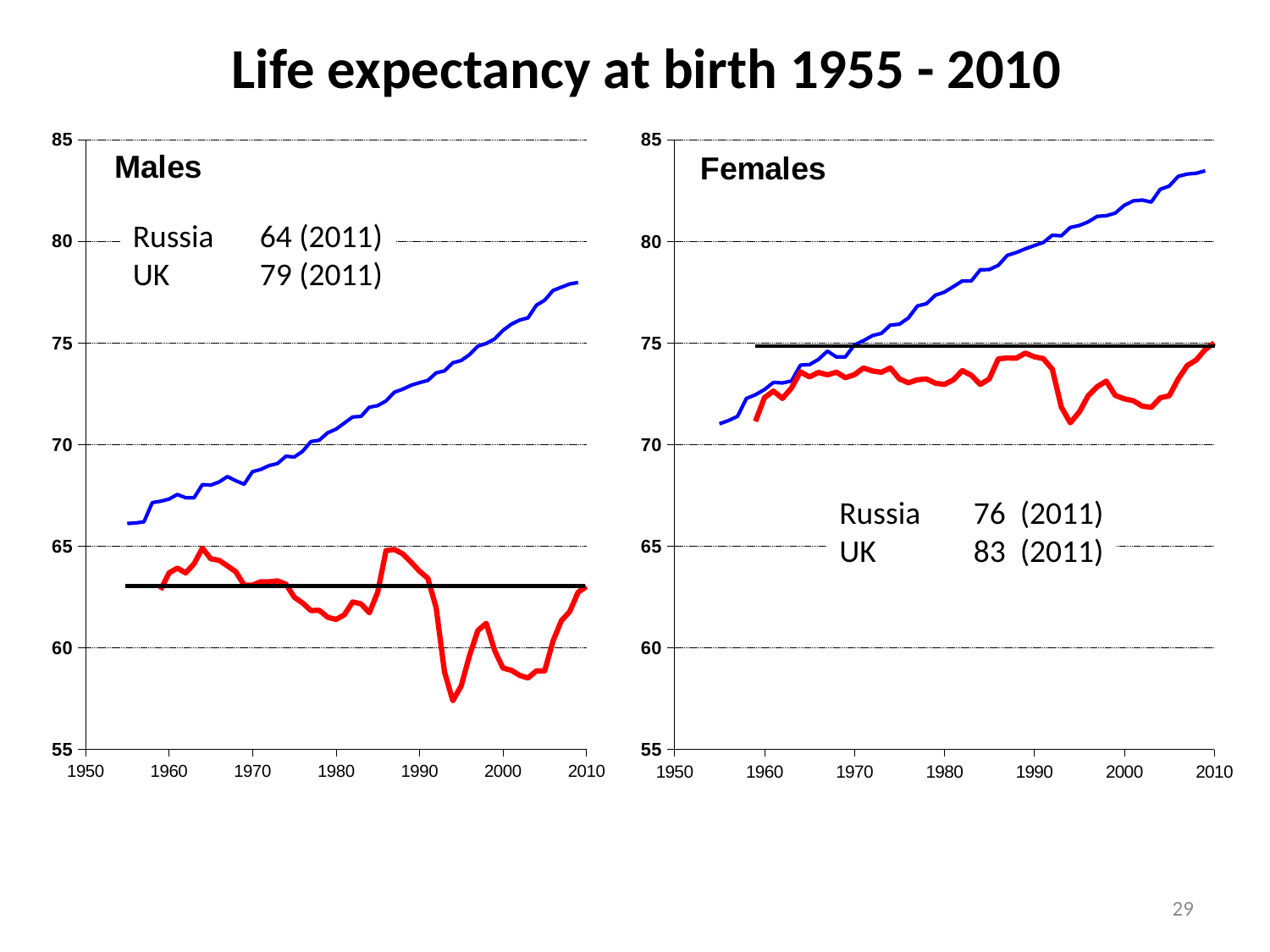
What kind of chart is the Males chart on the left? line chart In the Males chart, what is the 2011 life expectancy value given for the UK? 79 In the Males chart, what is the 2011 life expectancy value given for Russia? 64 In the Females chart, which country has the higher life expectancy in 2010, Russia or the UK? UK In the Females chart, what is the difference between the 2011 values for the UK and Russia? 7 In the Males chart, what is the difference between the 2011 values for the UK and Russia? 15 In the Females chart, what is the 2011 life expectancy value given for Russia? 76 In the Males chart, does the blue UK line rise or fall from 1955 to 2010? rise In the Males chart, is the value of the red Russia line around 1994 greater or less than 60? less In the Females chart, what is the 2011 life expectancy value given for the UK? 83 How many line series are plotted in the Females chart? 2 In the Females chart, is the value of the blue UK line in 2010 greater or less than 80? greater